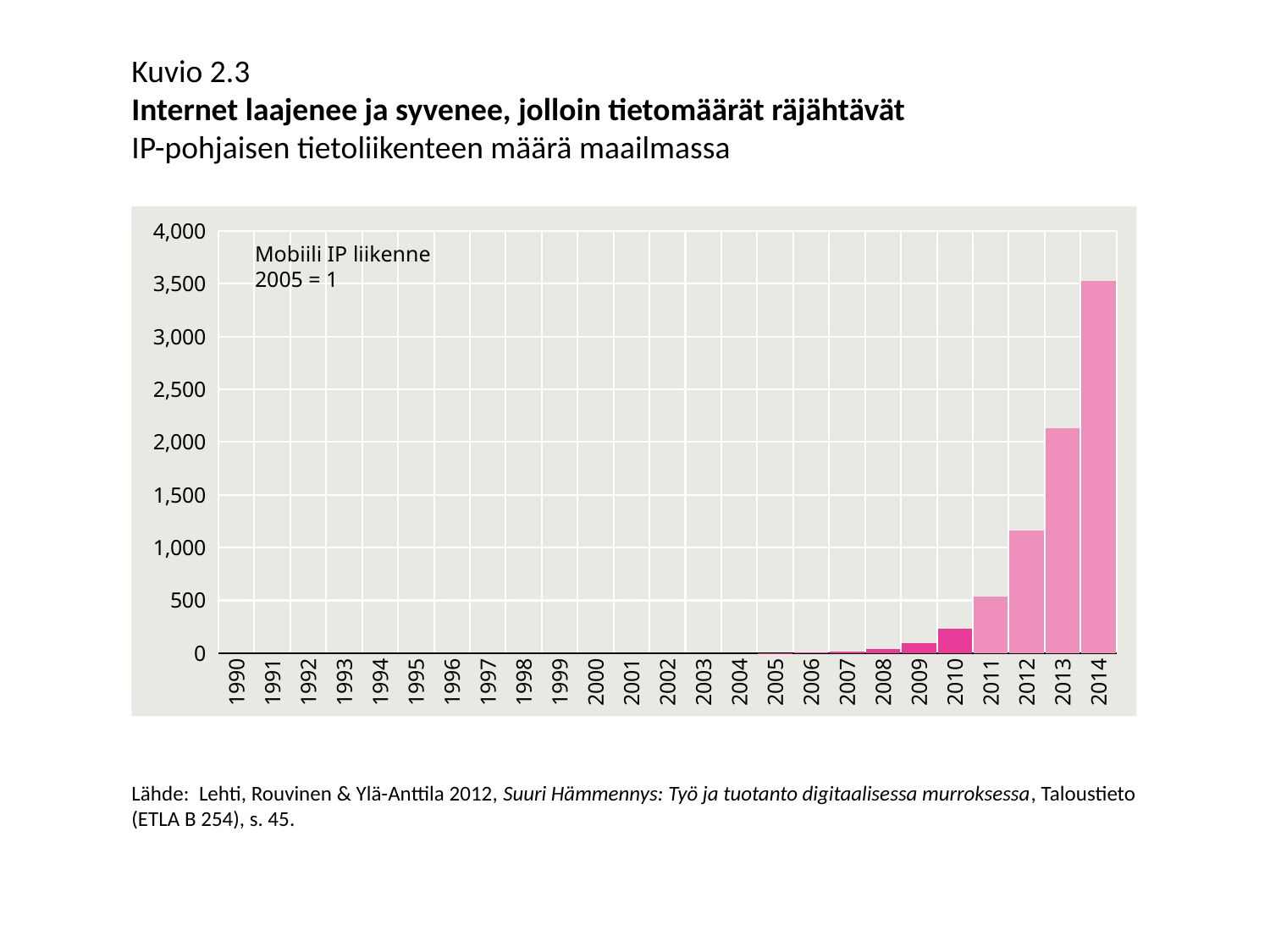
Which is larger, the value for 2013 or the value for 2012? 2013 What kind of chart is shown on the slide? bar chart Is the value for 2014 greater or less than 3,000? greater What base year is the index set to 1, according to the label inside the chart? 2005 Is the value for 2012 greater or less than 1,000? greater Is the value for 2011 greater or less than 1,000? less What is the first year shown on the x axis? 1990 Which year has the highest value in the chart? 2014 How many years are shown on the x axis of the chart? 25 Do the values rise or fall from 2009 to 2014? rise